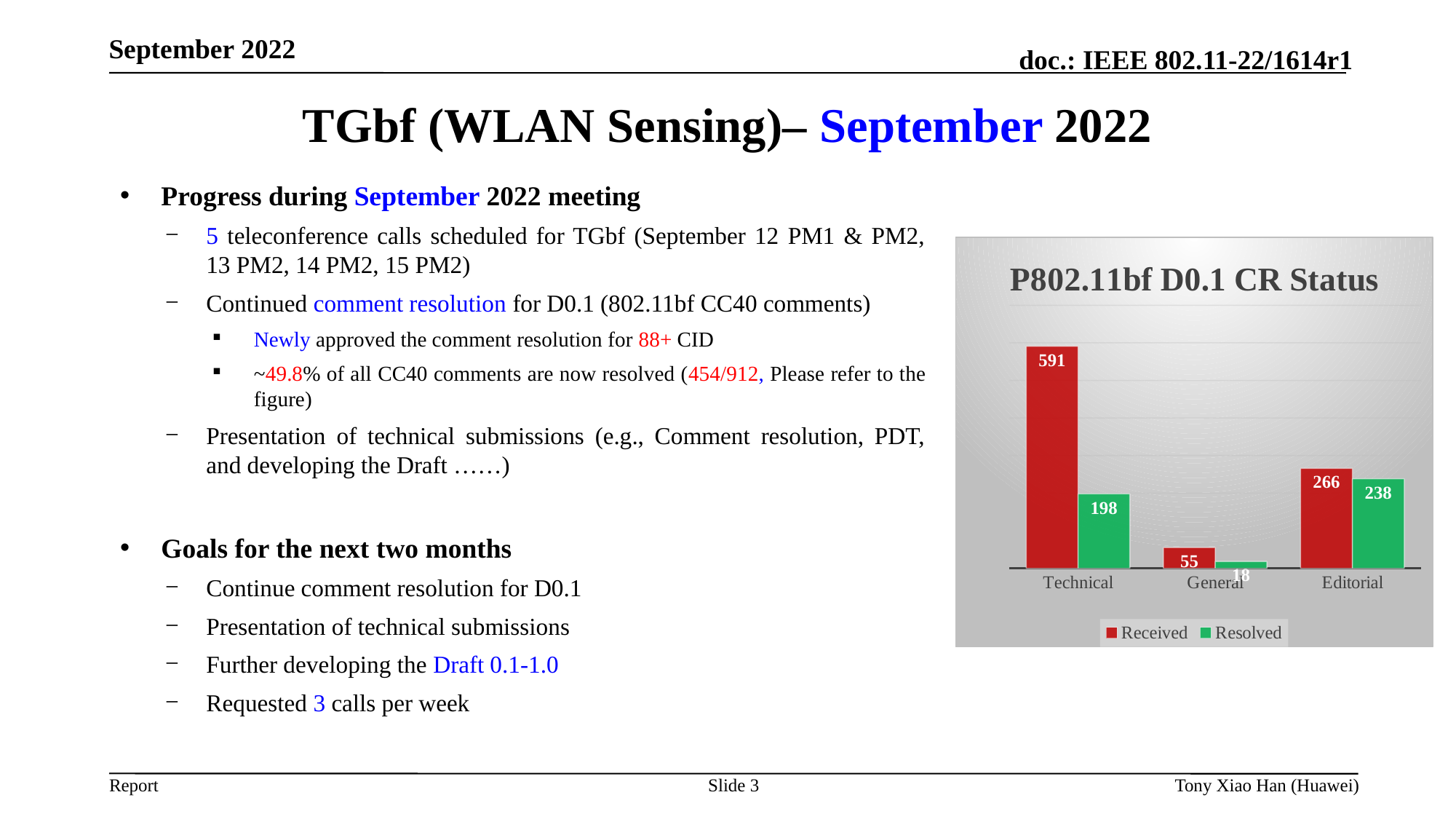
How many series does the legend of the P802.11bf D0.1 CR Status chart list? 2 What is the Received value for Technical in the P802.11bf D0.1 CR Status chart? 591 What is the difference between Received and Resolved for Editorial in the P802.11bf D0.1 CR Status chart? 28 What is the difference between Received and Resolved for Technical in the P802.11bf D0.1 CR Status chart? 393 Is the Resolved value for Technical larger or smaller than the Received value for Editorial in the P802.11bf D0.1 CR Status chart? smaller What is the Received value for General in the P802.11bf D0.1 CR Status chart? 55 How many categories are shown on the x axis of the P802.11bf D0.1 CR Status chart? 3 What type of chart is the P802.11bf D0.1 CR Status chart? bar chart Which category has the lowest Resolved value in the P802.11bf D0.1 CR Status chart? General What is the Resolved value for Editorial in the P802.11bf D0.1 CR Status chart? 238 What colour are the Resolved bars in the P802.11bf D0.1 CR Status chart? green Which category has the highest Received value in the P802.11bf D0.1 CR Status chart? Technical